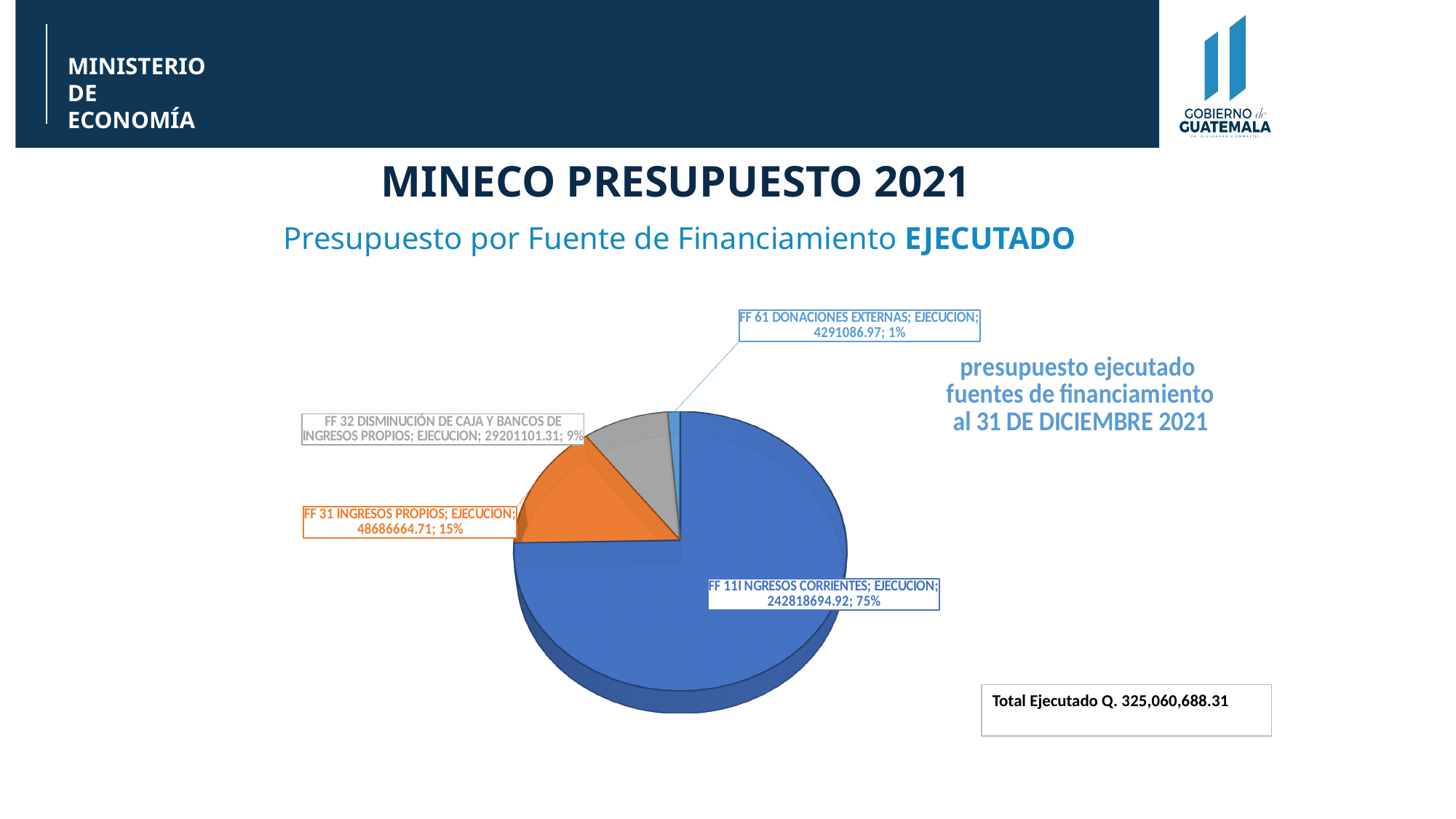
What type of chart is shown on the slide? Pie chart What is the total executed amount shown on the slide? Q. 325,060,688.31 What share of the pie does FF 32 DISMINUCIÓN DE CAJA Y BANCOS DE INGRESOS PROPIOS represent? 9% How many slices does the pie chart have? 4 What is the executed value for FF 61 DONACIONES EXTERNAS? 4291086.97 Which funding source has the largest slice of the pie? FF 11 INGRESOS CORRIENTES Which is larger, the executed value for FF 31 INGRESOS PROPIOS or for FF 32 DISMINUCIÓN DE CAJA Y BANCOS DE INGRESOS PROPIOS? FF 31 INGRESOS PROPIOS What is the executed value for FF 32 DISMINUCIÓN DE CAJA Y BANCOS DE INGRESOS PROPIOS? 29201101.31 What share of the pie does FF 11 INGRESOS CORRIENTES represent? 75% What is the executed value for FF 31 INGRESOS PROPIOS? 48686664.71 Which funding source has the smallest slice of the pie? FF 61 DONACIONES EXTERNAS What is the executed value for FF 11 INGRESOS CORRIENTES? 242818694.92